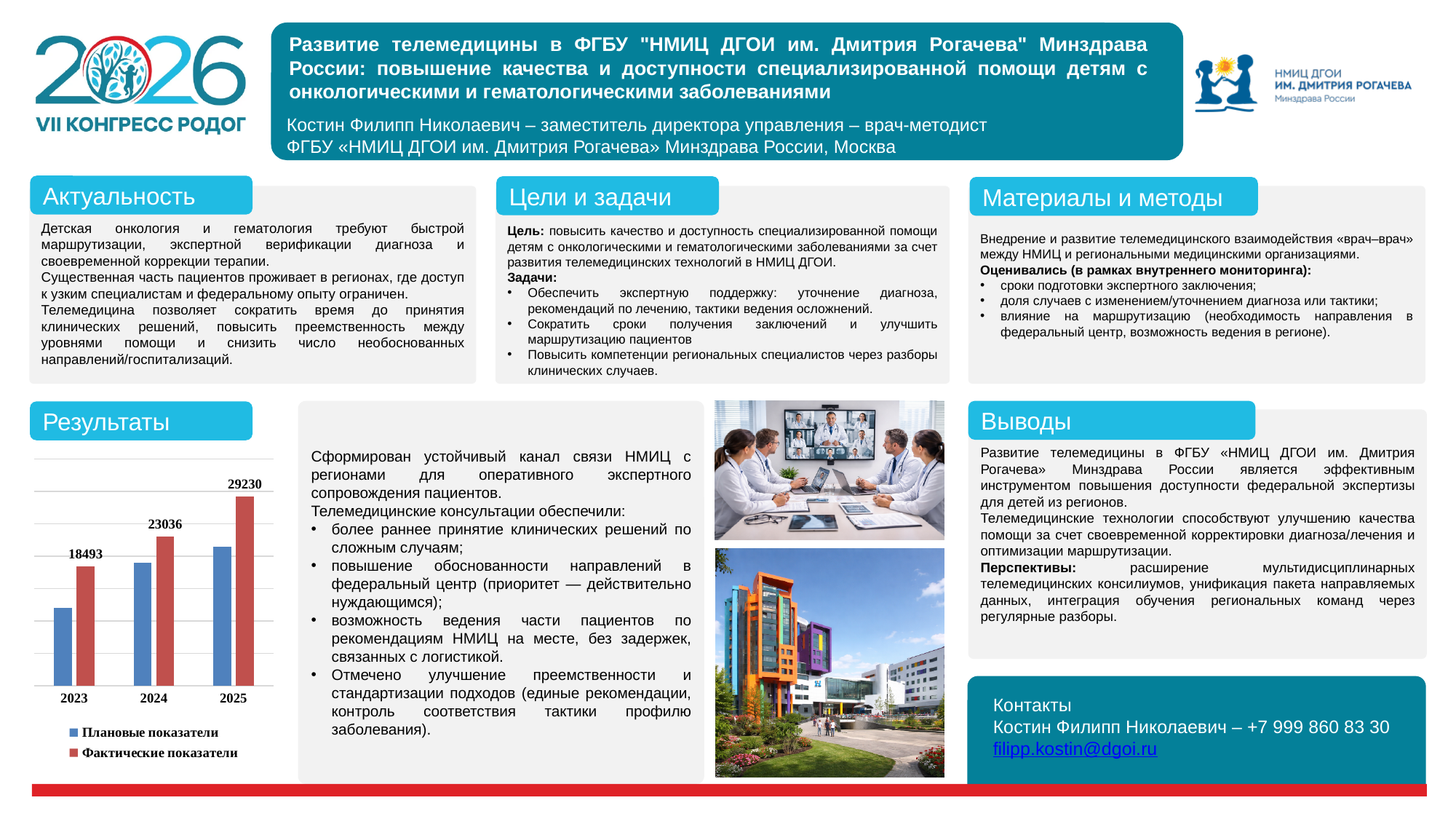
Which year has the highest value of Фактические показатели? 2025 Which year has the lowest value of Фактические показатели? 2023 In 2023, which is larger: Плановые показатели or Фактические показатели? Фактические показатели Do the values of Фактические показатели rise or fall from 2023 to 2025? rise What is the difference between Фактические показатели in 2025 and 2024? 6194 What is the difference between Фактические показатели in 2024 and 2023? 4543 What is the value of Фактические показатели for 2024? 23036 How many series does the chart legend list? 2 What type of chart is shown in the Результаты section? bar chart How many years are shown on the x axis of the chart? 3 What is the value of Фактические показатели for 2025? 29230 What is the value of Фактические показатели for 2023? 18493